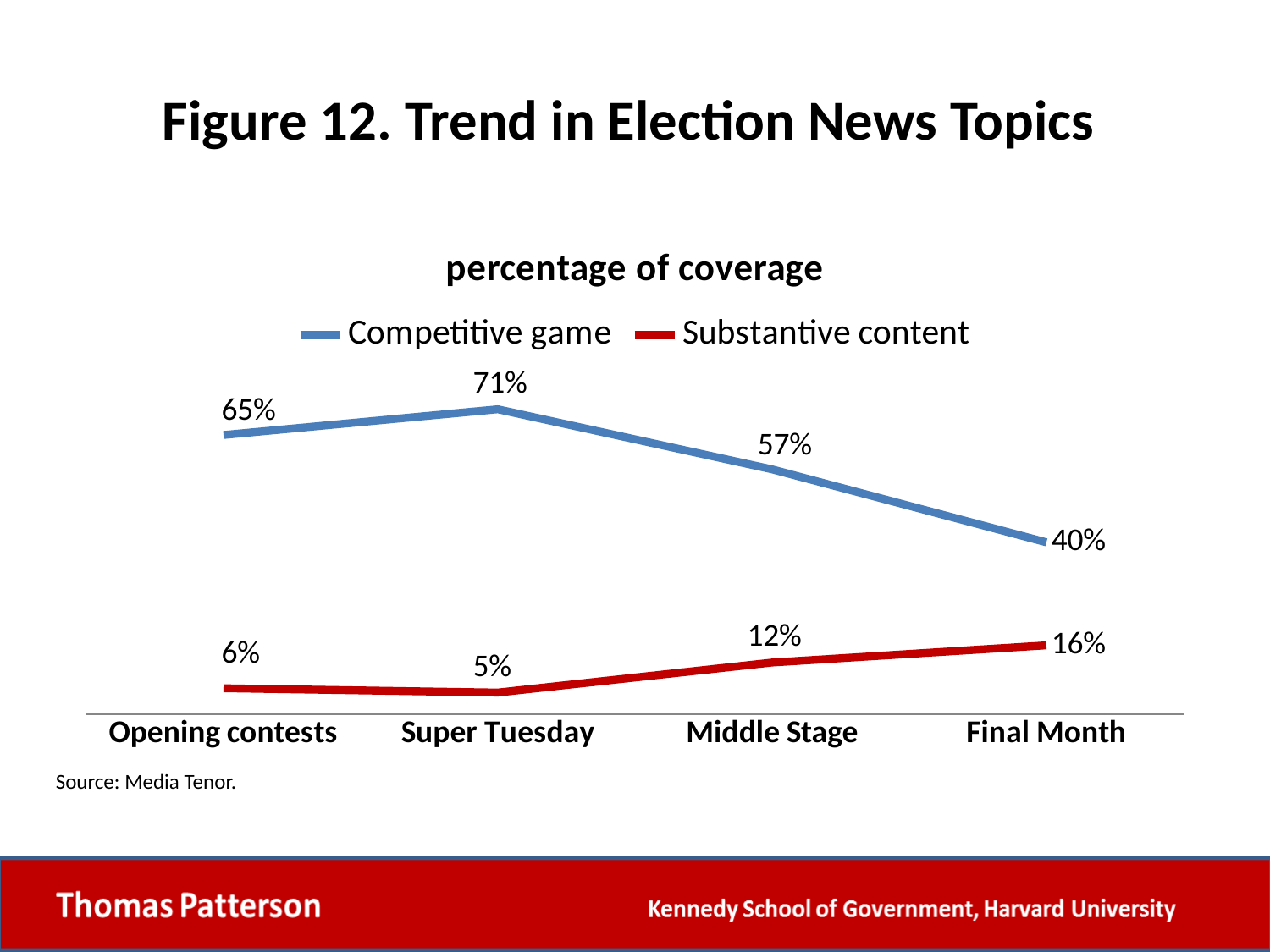
What is the chart's title? percentage of coverage Does Substantive content rise or fall from Super Tuesday to the Final Month? Rise How many stages are shown on the x axis? 4 What is the value for Substantive content at Middle Stage? 12% What kind of chart is shown? Line chart What is the difference between Competitive game and Substantive content at Opening contests? 59% Which is larger in the Final Month, Competitive game or Substantive content? Competitive game What is the value for Competitive game in the Final Month? 40% At which stage is Substantive content lowest? Super Tuesday At which stage is Competitive game highest? Super Tuesday How many series does the legend list? 2 What is the value for Competitive game at Super Tuesday? 71%